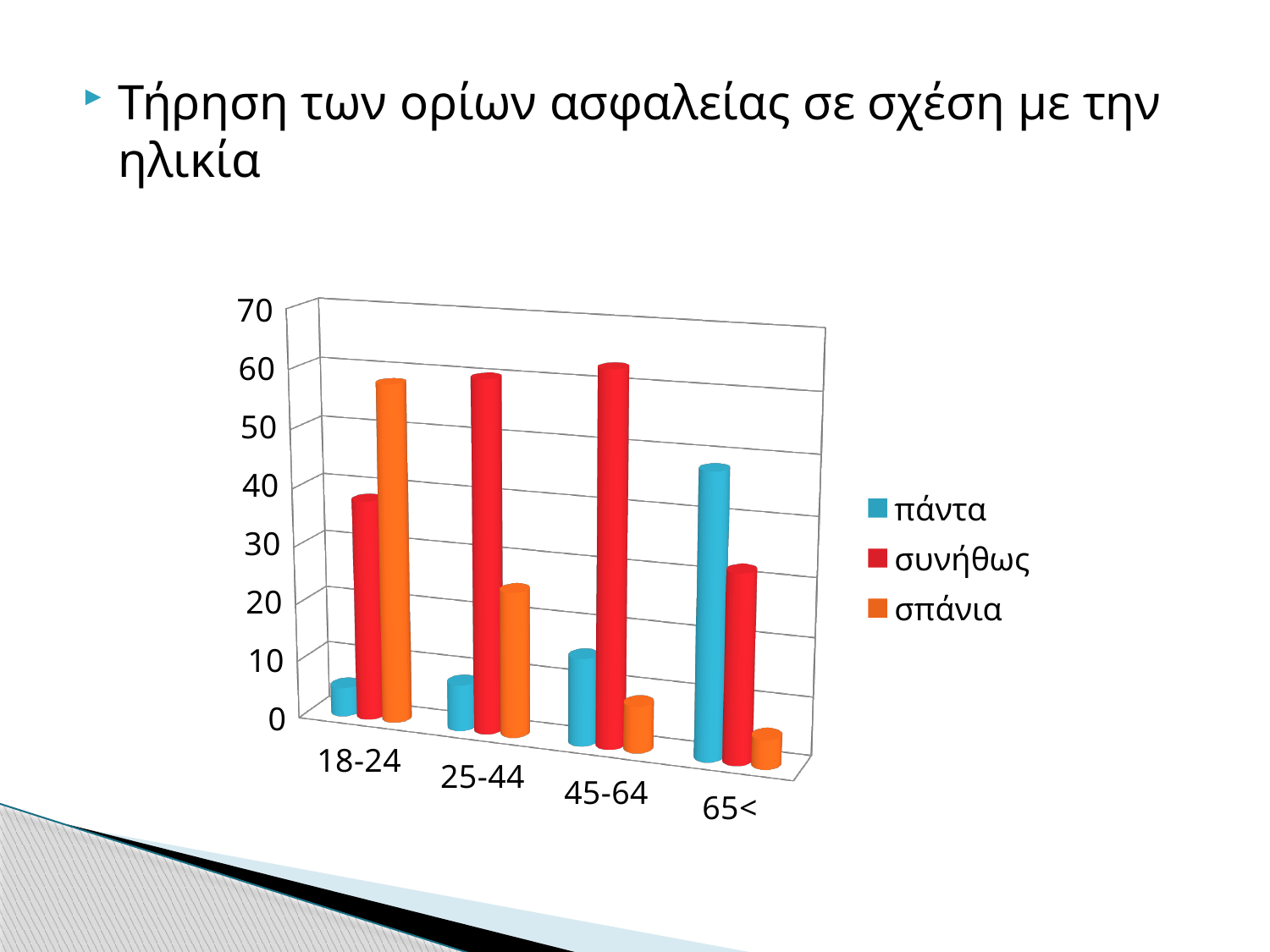
Do the values for πάντα rise or fall as the age groups move from 18-24 to 65<? rise Which age group has the highest value for σπάνια? 18-24 Which age group has the highest value for πάντα? 65< How many age categories are shown on the x axis? 4 Which age group has the lowest value for συνήθως? 65< In the 65< group, which is larger: πάντα or συνήθως? πάντα Is the value for σπάνια in the 18-24 group greater or less than 50? greater In the 18-24 group, which is larger: σπάνια or συνήθως? σπάνια Is the value for πάντα in the 18-24 group greater or less than 10? less How many series does the legend list? 3 Is the value for πάντα in the 65< group greater or less than 30? greater What kind of chart is shown on the slide? bar chart